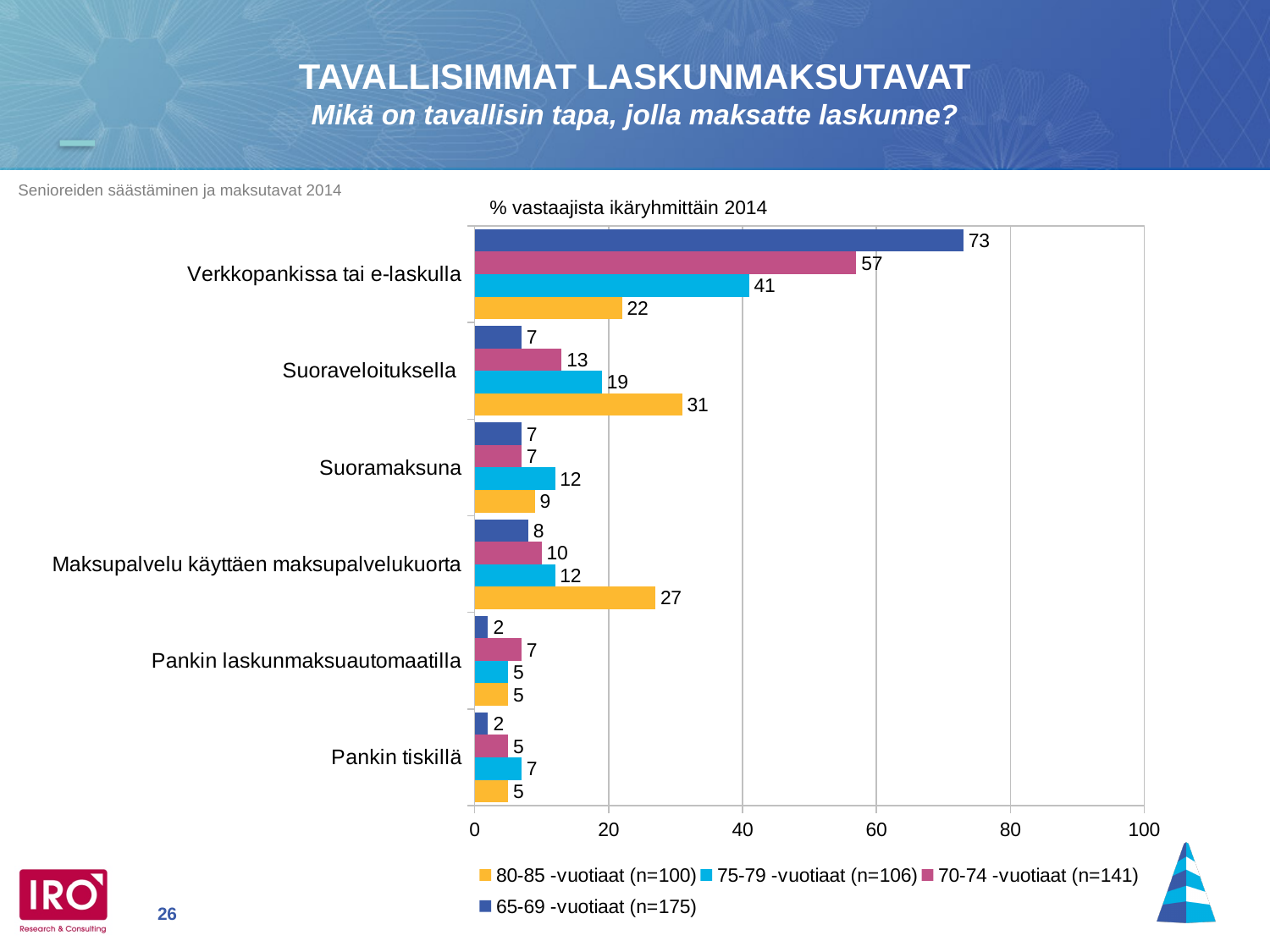
Is the value for 70-74 -vuotiaat in Verkkopankissa tai e-laskulla greater or less than 40? greater For Suoraveloituksella, which age group has the larger value: 80-85 -vuotiaat or 65-69 -vuotiaat? 80-85 -vuotiaat What is the sample size (n) for the 70-74 -vuotiaat group shown in the legend? n=141 What percentage of 65-69 -vuotiaat pay their bills Verkkopankissa tai e-laskulla? 73 How many age-group series does the legend list? 4 What is the difference between the 65-69 -vuotiaat and 80-85 -vuotiaat values for Verkkopankissa tai e-laskulla? 51 Which category has the lowest value for 65-69 -vuotiaat? Pankin laskunmaksuautomaatilla and Pankin tiskillä (both 2) What type of chart is shown on the slide? Bar chart How many payment-method categories are shown on the chart? 6 What is the value for 75-79 -vuotiaat in the Maksupalvelu käyttäen maksupalvelukuorta category? 12 Which category has the highest value for 70-74 -vuotiaat? Verkkopankissa tai e-laskulla What is the value for 80-85 -vuotiaat in the Suoraveloituksella category? 31